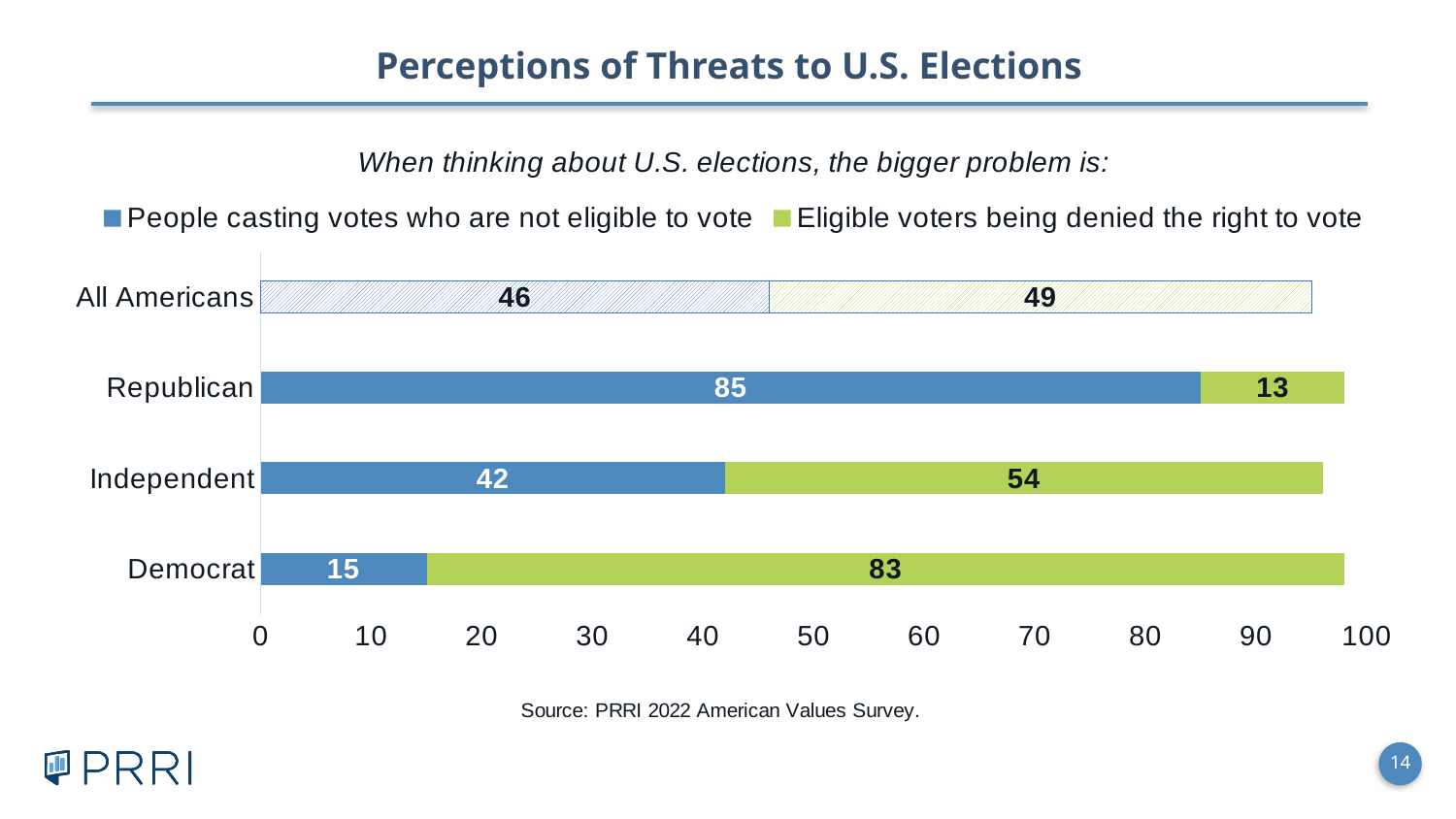
How many groups are shown on the chart? 4 What is the difference between the Republican and Democrat values for 'People casting votes who are not eligible to vote'? 70 How many series does the legend list? 2 What is the value for All Americans for 'Eligible voters being denied the right to vote'? 49 What is the total of the two segments in the Independent bar? 96 What percentage of Republicans say people casting votes who are not eligible to vote is the bigger problem? 85 What kind of chart is shown on the slide? Stacked bar chart Which group has the highest value for 'People casting votes who are not eligible to vote'? Republican Which group has the lowest value for 'Eligible voters being denied the right to vote'? Republican What is the value for Independents for 'People casting votes who are not eligible to vote'? 42 Which is larger for Independents: 'People casting votes who are not eligible to vote' or 'Eligible voters being denied the right to vote'? Eligible voters being denied the right to vote What percentage of Democrats say eligible voters being denied the right to vote is the bigger problem? 83